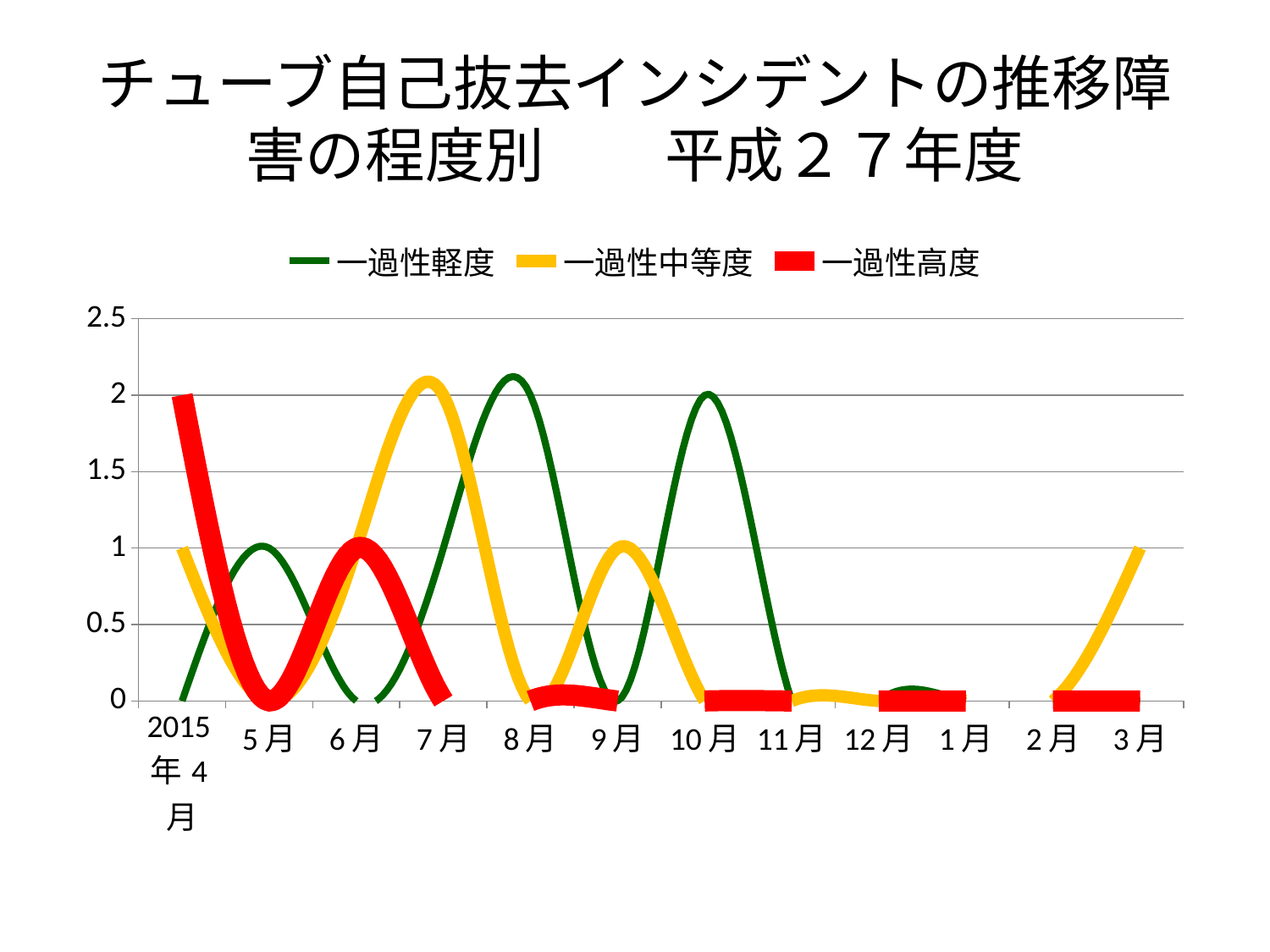
How many months are shown along the x axis? 12 What kind of chart is shown on the slide? line chart What colour is used for the 一過性高度 series? red In which month does 一過性高度 reach its highest value? 2015年4月 Is the value for 一過性中等度 in 7月 greater or less than 1.5? greater What is the value for 一過性高度 in 2015年4月? 2 In 2015年4月, which series has the larger value, 一過性高度 or 一過性中等度? 一過性高度 Is the value for 一過性軽度 in 8月 greater or less than 1.5? greater What is the value for 一過性中等度 in 2015年4月? 1 In 7月, which series has the larger value, 一過性中等度 or 一過性軽度? 一過性中等度 Is the value for 一過性高度 in 6月 greater or less than 1.5? less How many series does the legend list? 3